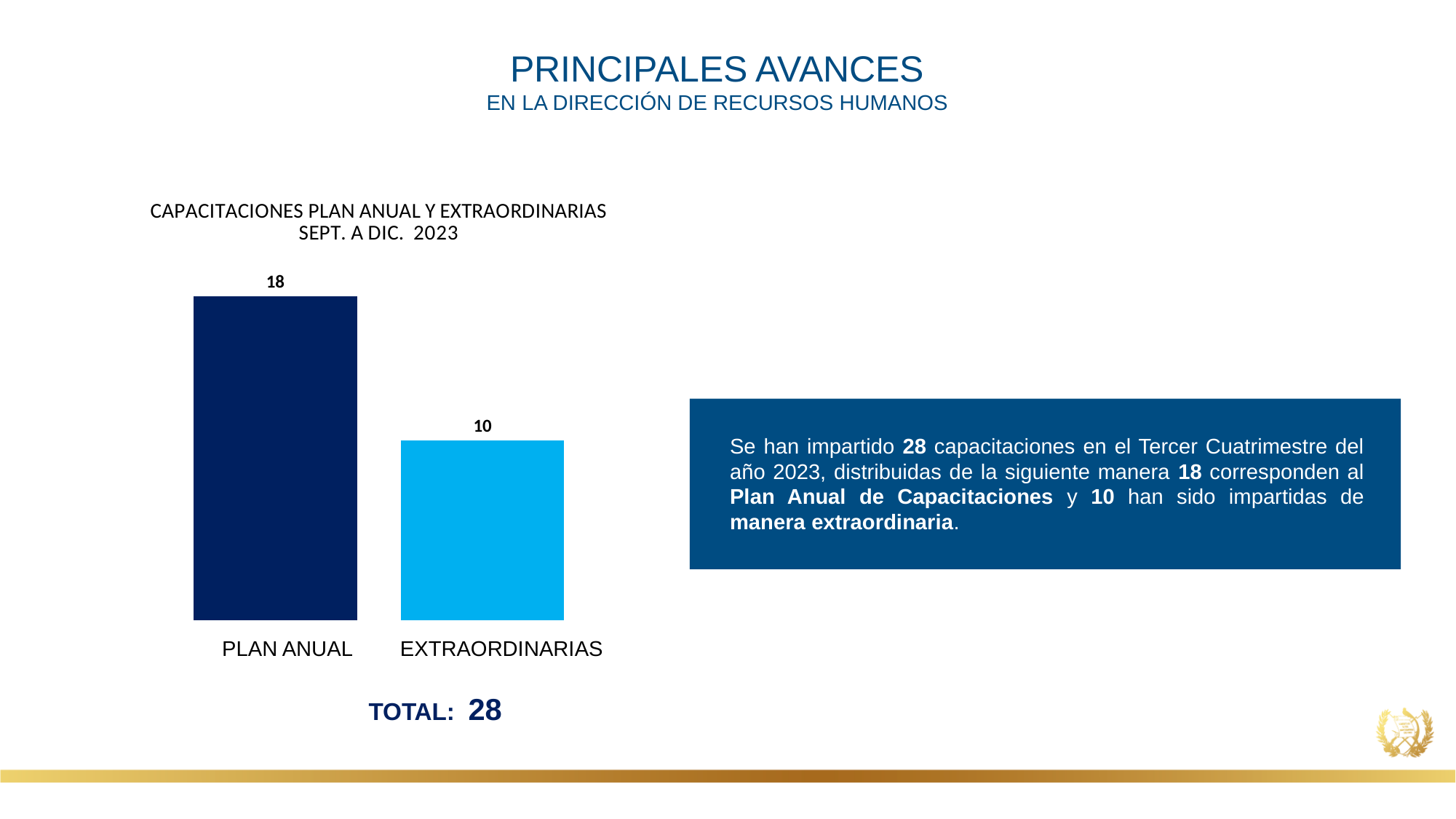
What is the difference between the values for PLAN ANUAL and EXTRAORDINARIAS? 8 What is the value for PLAN ANUAL? 18 What colour is the bar for EXTRAORDINARIAS? Light blue Which category has the highest value? PLAN ANUAL What kind of chart is shown on the slide? Bar chart How many categories are shown in the chart? 2 Which is larger, the value for PLAN ANUAL or the value for EXTRAORDINARIAS? PLAN ANUAL What is the title of the chart? CAPACITACIONES PLAN ANUAL Y EXTRAORDINARIAS SEPT. A DIC. 2023 What is the total of the two values shown in the chart? 28 What is the value for EXTRAORDINARIAS? 10 Which category has the lowest value? EXTRAORDINARIAS